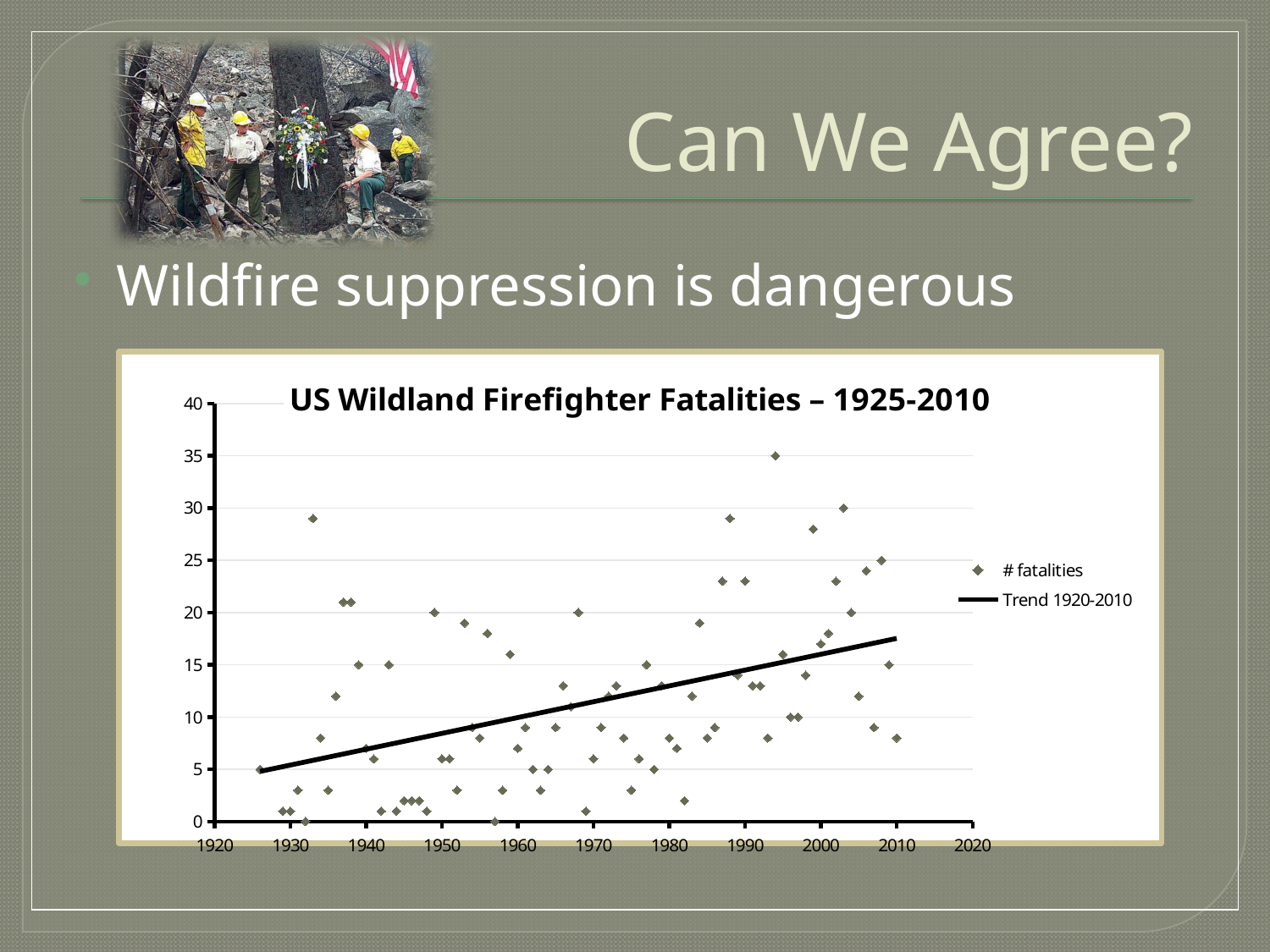
What is the maximum value shown on the vertical axis? 40 What is the title of the chart? US Wildland Firefighter Fatalities – 1925-2010 What kind of chart is shown on the slide? Scatter chart How many series does the chart legend list? 2 Is the highest plotted fatalities value greater or less than 30? greater Is the fatalities value plotted around 1933 greater or less than 25? greater Which is larger, the fatalities value plotted around 1994 or the one plotted around 1926? 1994 Does the trend line for 1920-2010 rise or fall from left to right? Rises What is the highest number of fatalities plotted on the chart? 35 Is the fatalities value plotted around 2003 greater or less than 25? greater What are the two entries in the chart legend? # fatalities and Trend 1920-2010